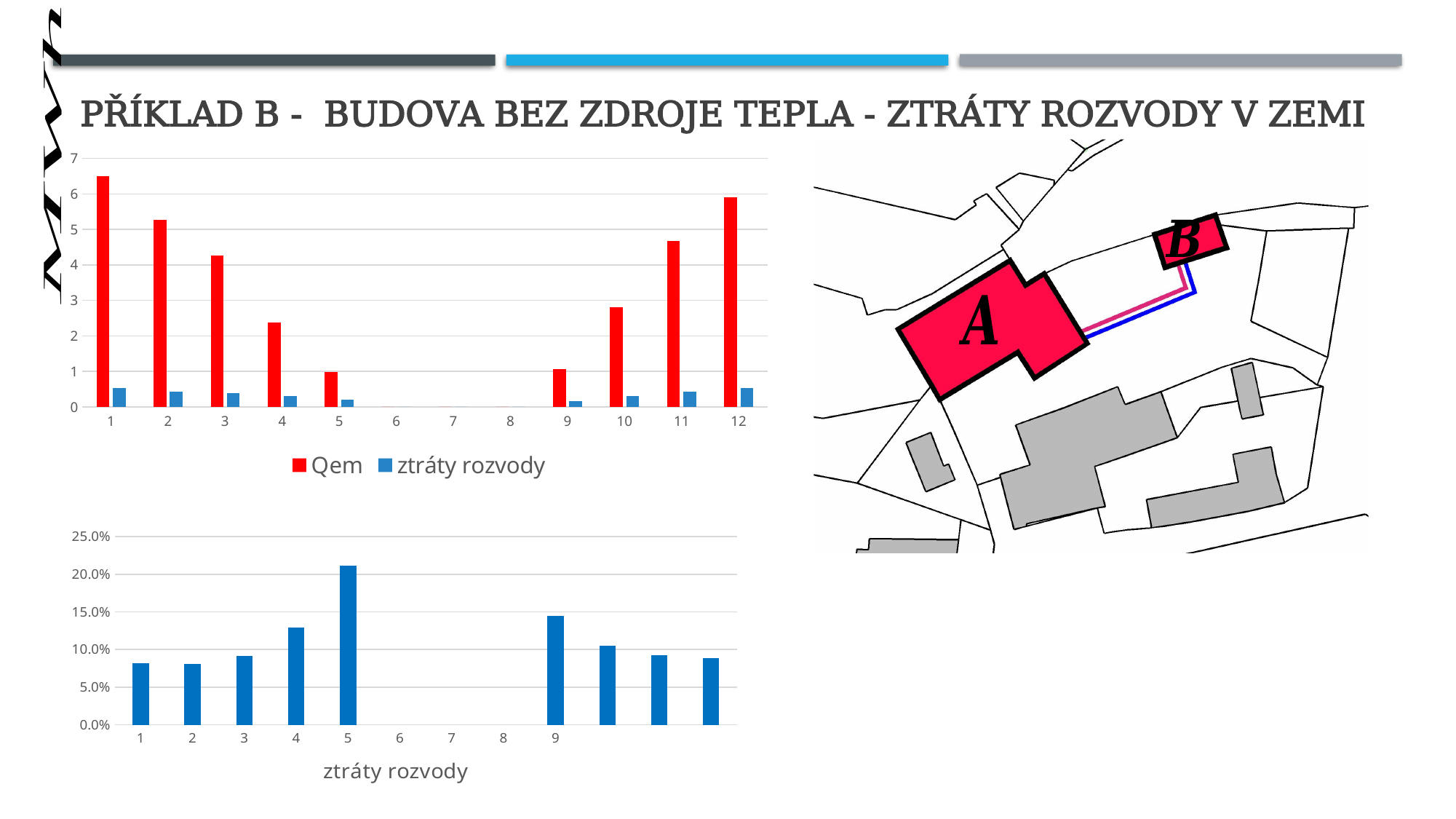
On the bottom chart (ztráty rozvody), is the value for category 5 greater or less than 20.0%? greater On the top chart, is the Qem value for category 10 greater or less than 2? greater On the top chart, how many categories are shown on the x axis? 12 On the bottom chart (ztráty rozvody), is the value for category 1 greater or less than 10.0%? less What kind of chart is the top chart? bar chart On the top chart, which category has the highest Qem value? 1 On the top chart, how many series does the legend list? 2 On the top chart, which is larger: the Qem value for category 2 or for category 11? category 2 On the top chart, what are the two legend entries? Qem and ztráty rozvody On the bottom chart (ztráty rozvody), which category has the highest value? 5